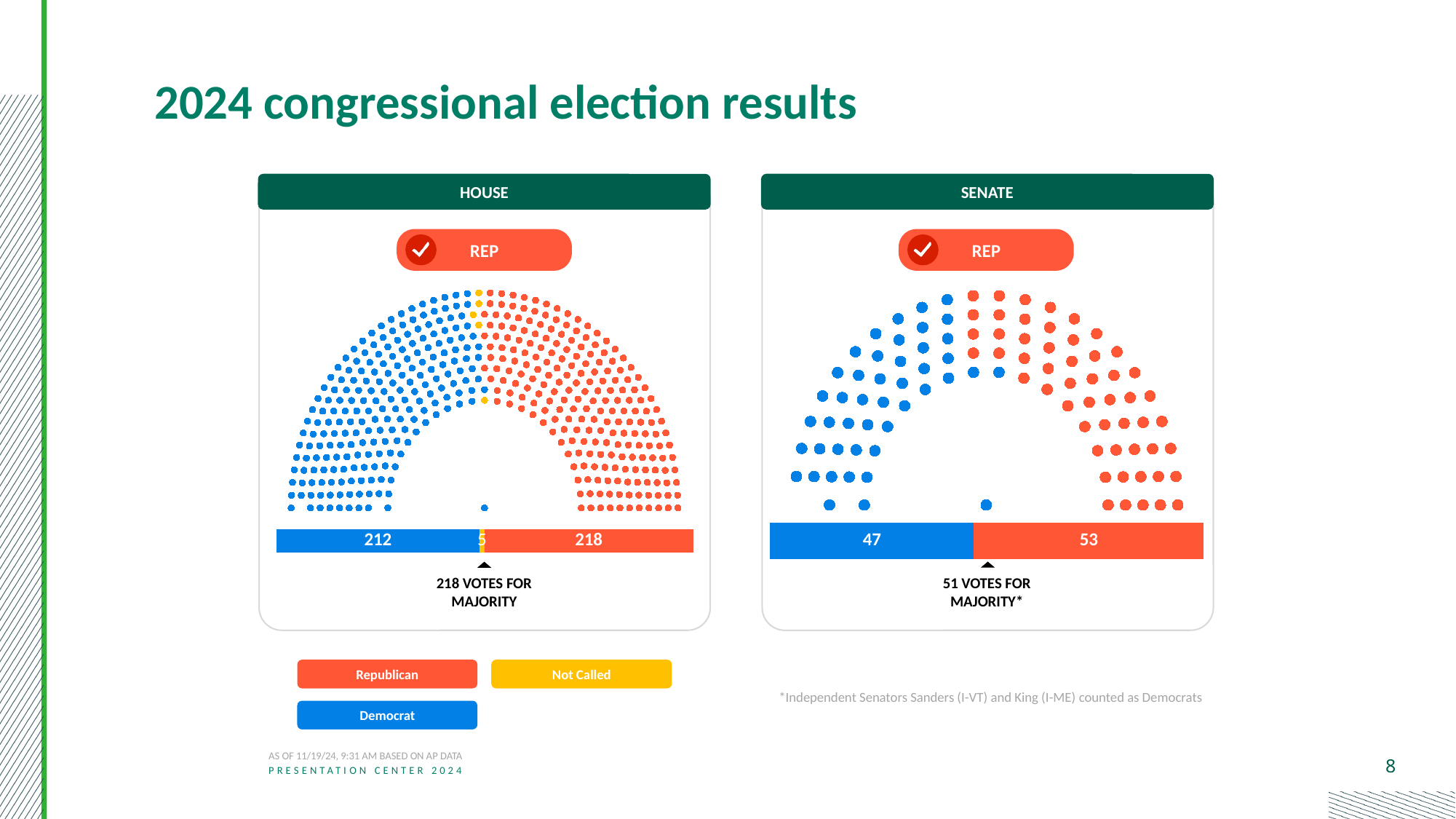
In the House chart, what is the total number of seats across Democrats, Not Called and Republicans? 435 In the House chart, which category has the fewest seats? Not Called In the Senate chart, which party has more seats, Democrats or Republicans? Republicans In the House chart, how many seats are shown for Democrats? 212 In the House chart, what is the difference between the Republican and Democrat seat counts? 6 In the House chart, how many seats are shown for Republicans? 218 In the Senate chart, how many seats are shown for Republicans? 53 How many votes are needed for a majority according to the Senate chart? 51 In the Senate chart, what is the difference between the Republican and Democrat seat counts? 6 How many categories does the legend below the House chart list? 3 In the Senate chart, how many seats are shown for Democrats? 47 In the House chart, how many seats are shown as Not Called? 5